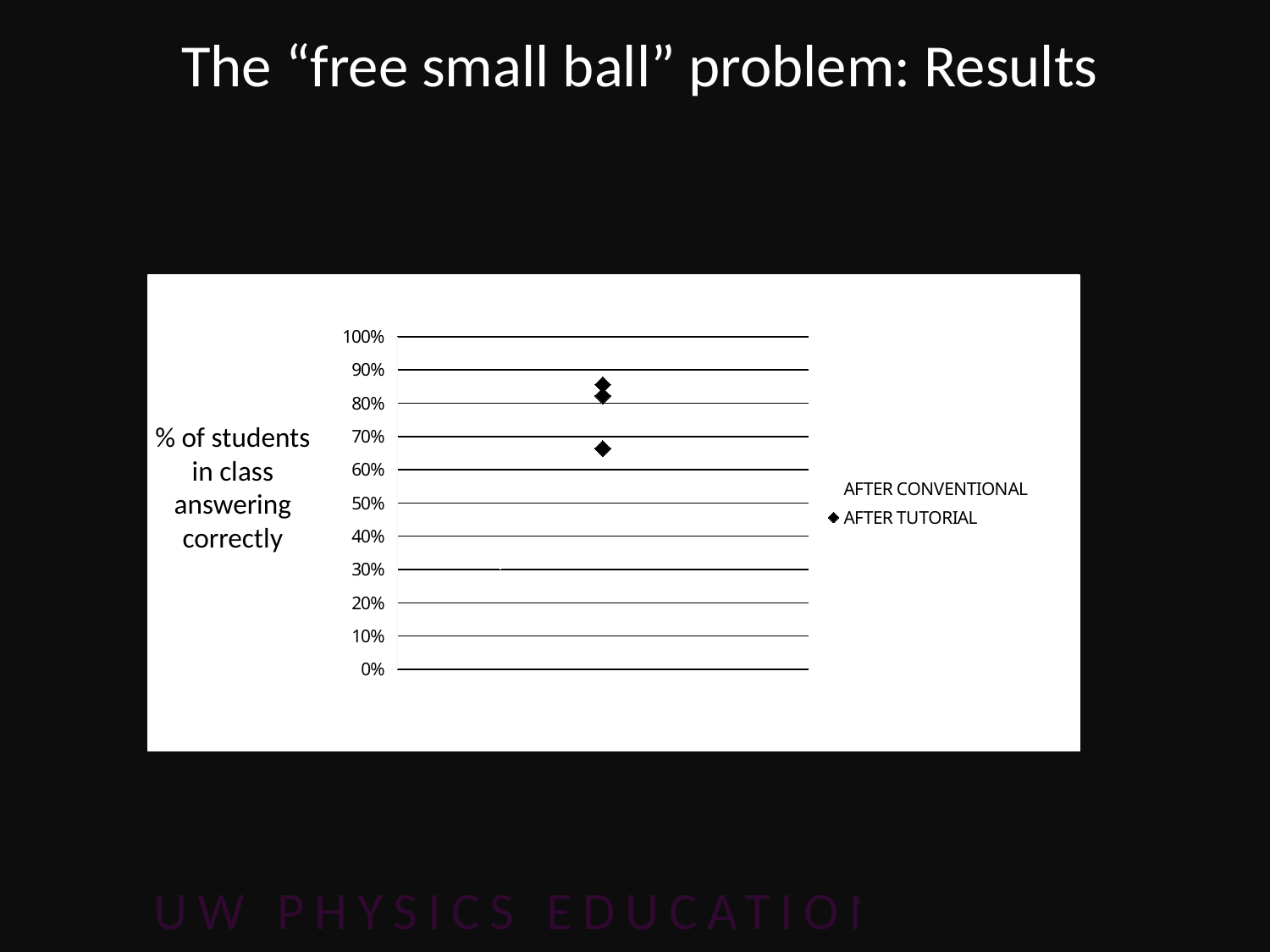
What is the label on the vertical axis of the chart? % of students in class answering correctly Is the lowest plotted AFTER TUTORIAL point greater or less than 70%? less Are all the plotted AFTER TUTORIAL points greater or less than 50%? greater Is the lowest plotted AFTER TUTORIAL point greater or less than 60%? greater What are the two series named in the chart legend? AFTER CONVENTIONAL and AFTER TUTORIAL What kind of chart is shown on the slide? scatter chart How many series does the chart legend list? 2 How many diamond markers are plotted on the chart? 3 What is the maximum value shown on the chart's vertical axis? 100%